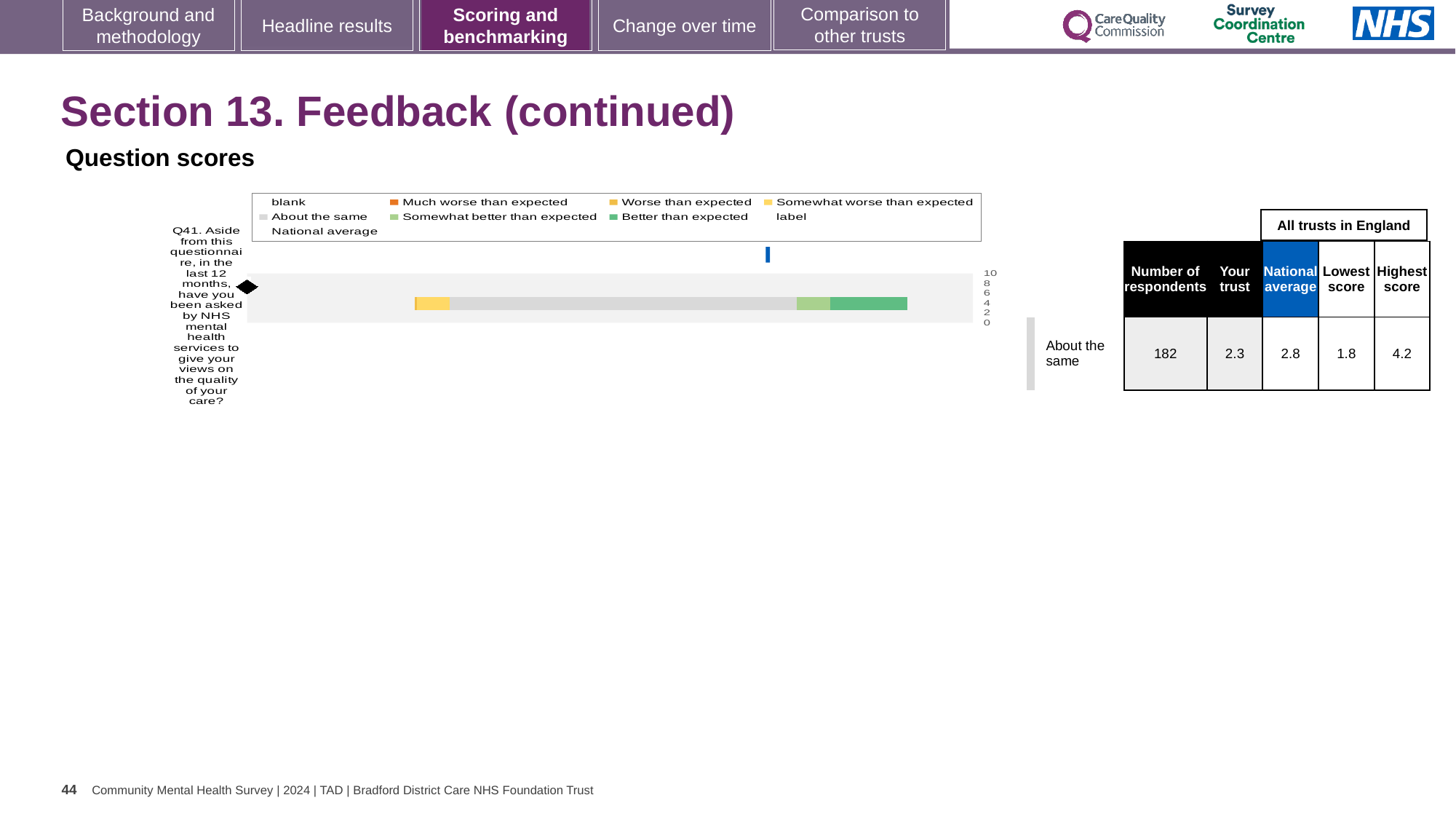
In the table beside the chart, what is the 'Your trust' score for Q41? 2.3 What is the difference between the Highest score and the Lowest score for Q41 in the table beside the chart? 2.4 What colour does the legend use for 'Better than expected'? green Which question number is plotted in the chart? Q41 In the table beside the chart, what is the Highest score among all trusts in England for Q41? 4.2 What is the highest value shown on the chart's score axis? 10 In the table beside the chart, what is the National average score for Q41? 2.8 Which is larger for Q41, the 'Your trust' score or the National average? National average What kind of chart is shown on the slide? bar chart In the table beside the chart, what is the Lowest score among all trusts in England for Q41? 1.8 How many respondents answered Q41 according to the table beside the chart? 182 How many questions (categories) are plotted in the chart? 1